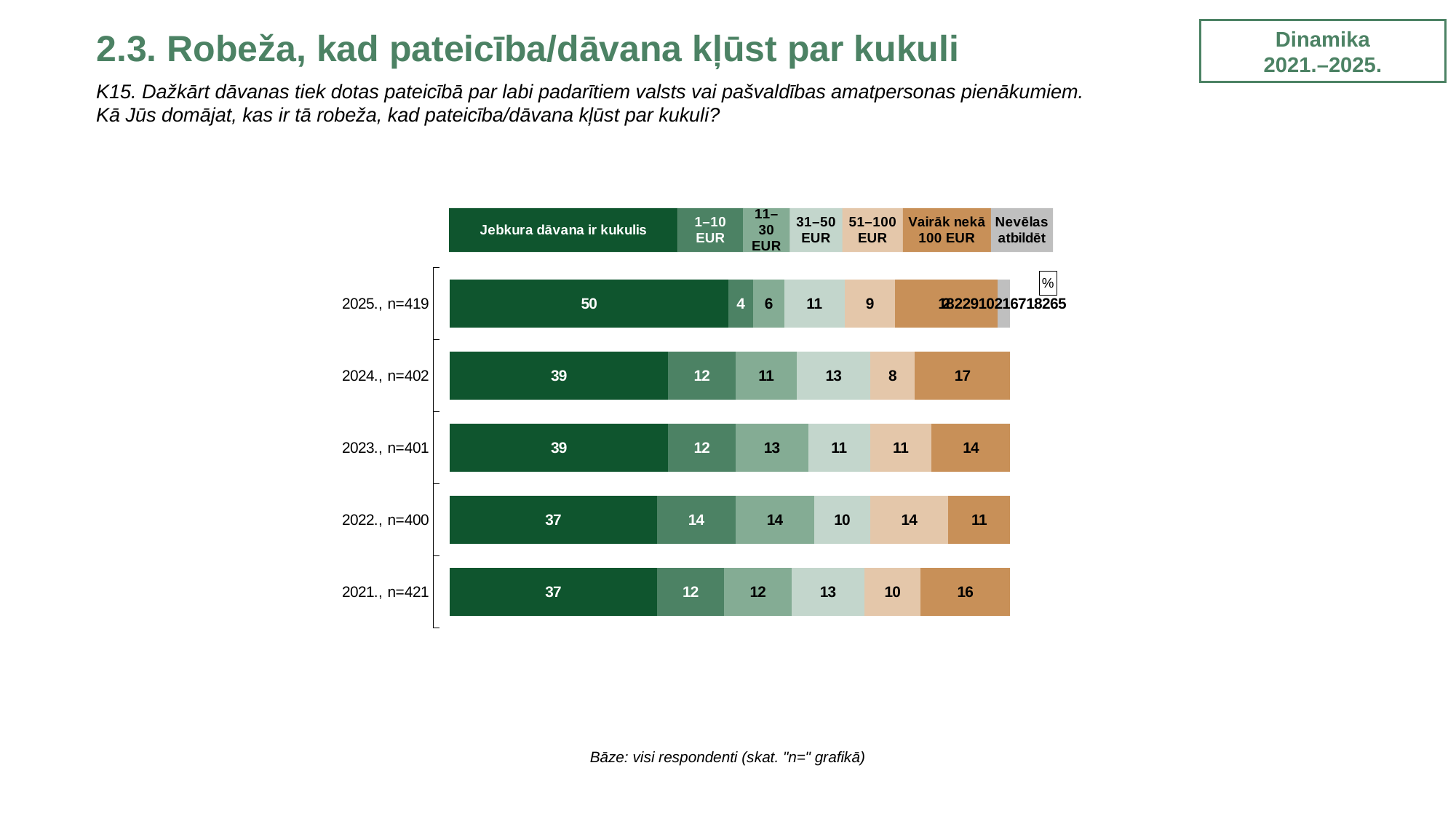
What is the difference between the "Jebkura dāvana ir kukulis" values for 2025., n=419 and 2024., n=402? 11 Which year has the larger "51–100 EUR" value, 2022., n=400 or 2021., n=421? 2022., n=400 How many series does the legend list? 7 What is the value for "11–30 EUR" in the 2023., n=401 bar? 13 What kind of chart is shown on the slide? Stacked bar chart What is the difference between the "51–100 EUR" values for 2023., n=401 and 2024., n=402? 3 What is the value for "Vairāk nekā 100 EUR" in the 2021., n=421 bar? 16 Which year has the lowest value for "1–10 EUR"? 2025., n=419 What is the value for "Jebkura dāvana ir kukulis" in the 2024., n=402 bar? 39 What is the value for "1–10 EUR" in the 2022., n=400 bar? 14 Which year has the highest value for "Jebkura dāvana ir kukulis"? 2025., n=419 How many years (bars) are shown in the chart? 5